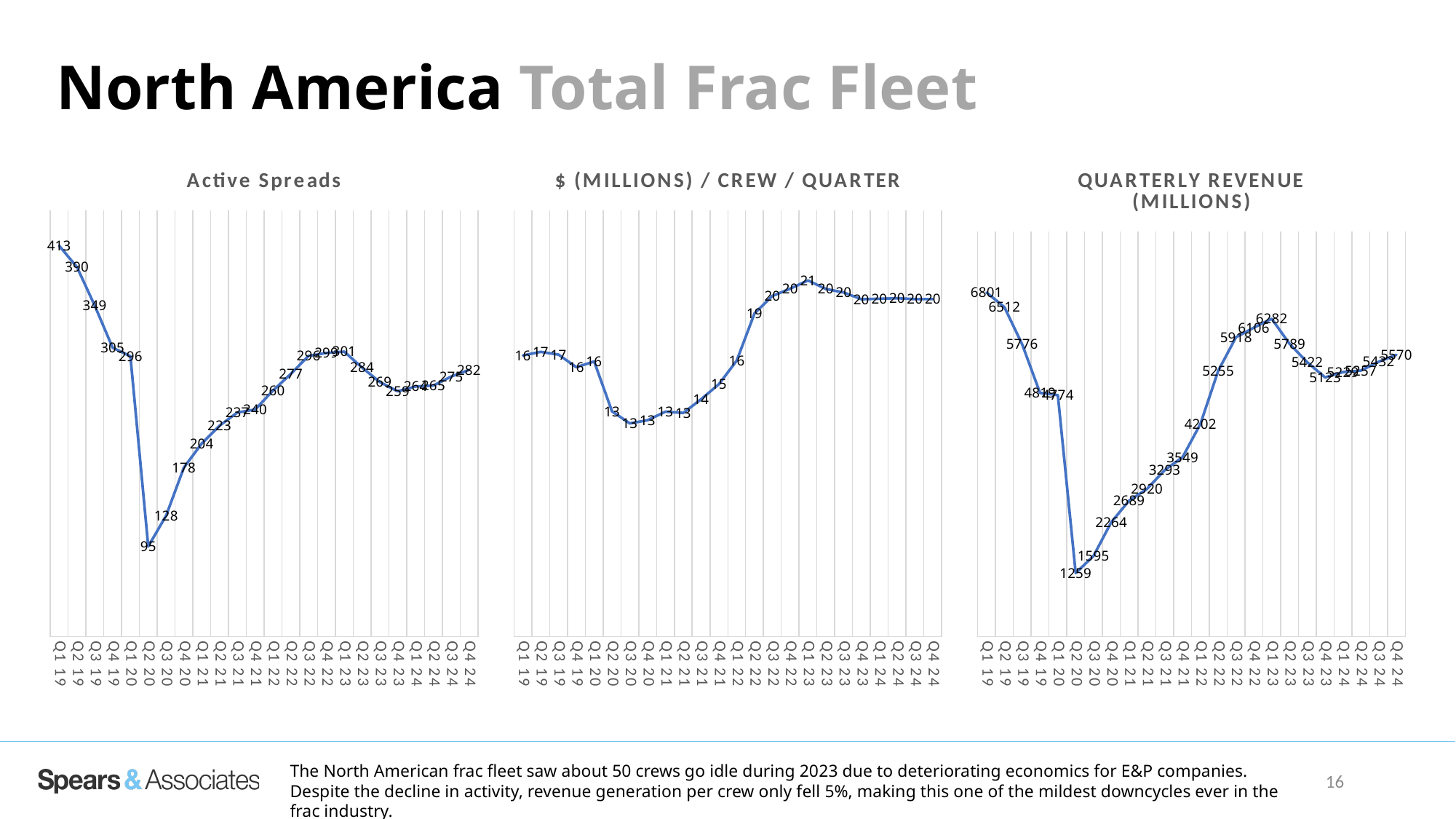
In the $ (MILLIONS) / CREW / QUARTER chart, what is the value for Q4 24? 20 What kind of chart is the Active Spreads chart? Line chart In the QUARTERLY REVENUE (MILLIONS) chart, which is larger, the value for Q1 23 or the value for Q4 24? Q1 23 In the Active Spreads chart, what is the value for Q4 24? 282 In the Active Spreads chart, what is the value for Q1 19? 413 In the Active Spreads chart, what is the difference between the Q1 19 value and the Q2 20 value? 318 In the Active Spreads chart, which quarter has the lowest value? Q2 20 How many quarters are plotted in the Active Spreads chart? 24 In the QUARTERLY REVENUE (MILLIONS) chart, which quarter has the lowest value? Q2 20 In the $ (MILLIONS) / CREW / QUARTER chart, which quarter has the highest value? Q1 23 In the QUARTERLY REVENUE (MILLIONS) chart, what is the value for Q1 19? 6801 In the QUARTERLY REVENUE (MILLIONS) chart, what is the difference between the Q1 23 value and the Q2 23 value? 493